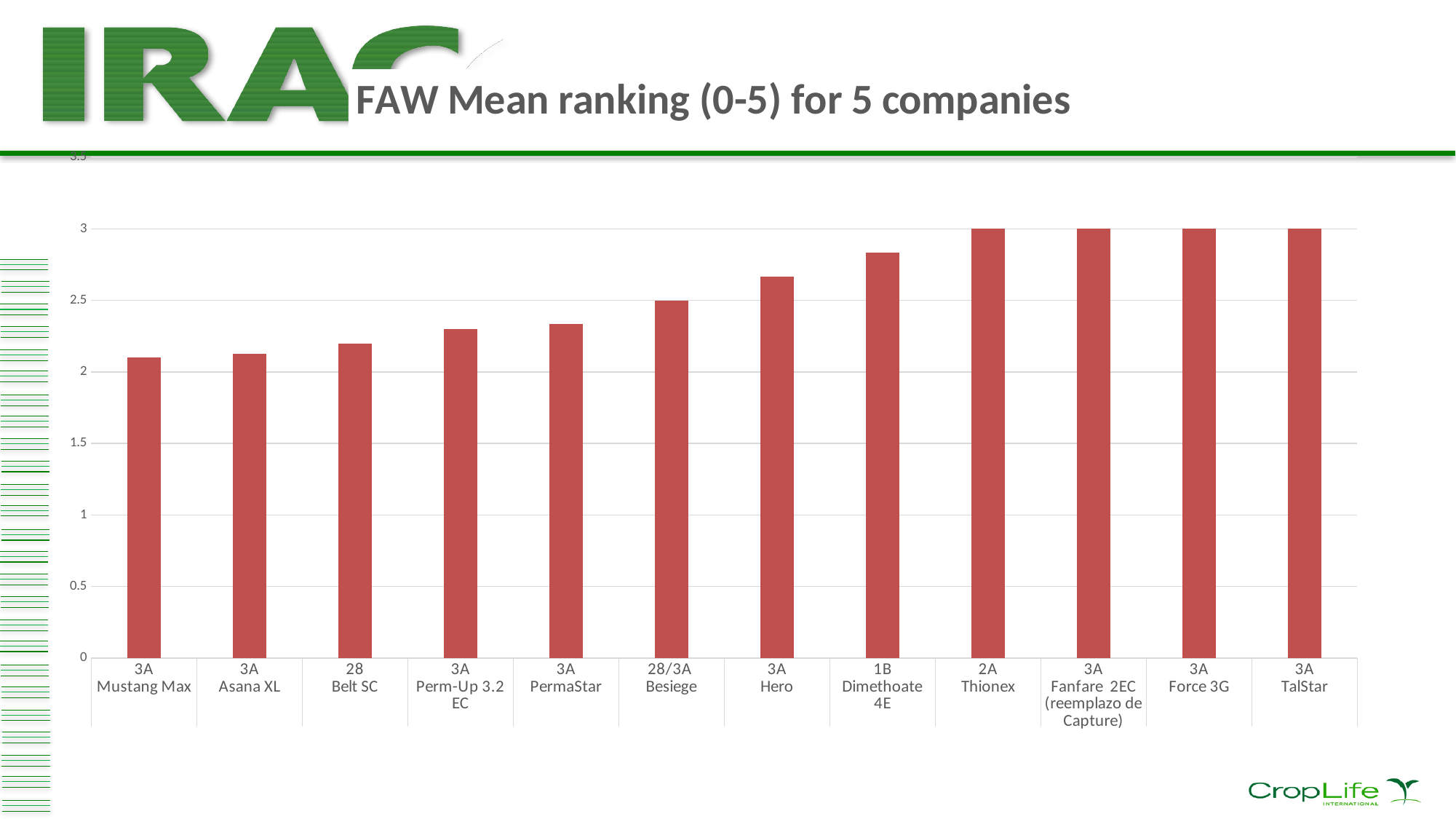
What is the mean ranking for 2A Thionex? 3 Is the value for 28 Belt SC greater or less than 2.5? less Do the values rise or fall moving from left to right along the x axis? Rise Which has a higher mean ranking, 3A Hero or 28 Belt SC? 3A Hero What is the mean ranking for 3A TalStar? 3 Is the value for 3A Mustang Max greater or less than 2? greater What is the title of the chart? FAW Mean ranking (0-5) for 5 companies Is the value for 1B Dimethoate 4E greater or less than 3? less What is the mean ranking for 28/3A Besiege? 2.5 What kind of chart is shown on the slide? Bar chart How many products (bars) are shown in the chart? 12